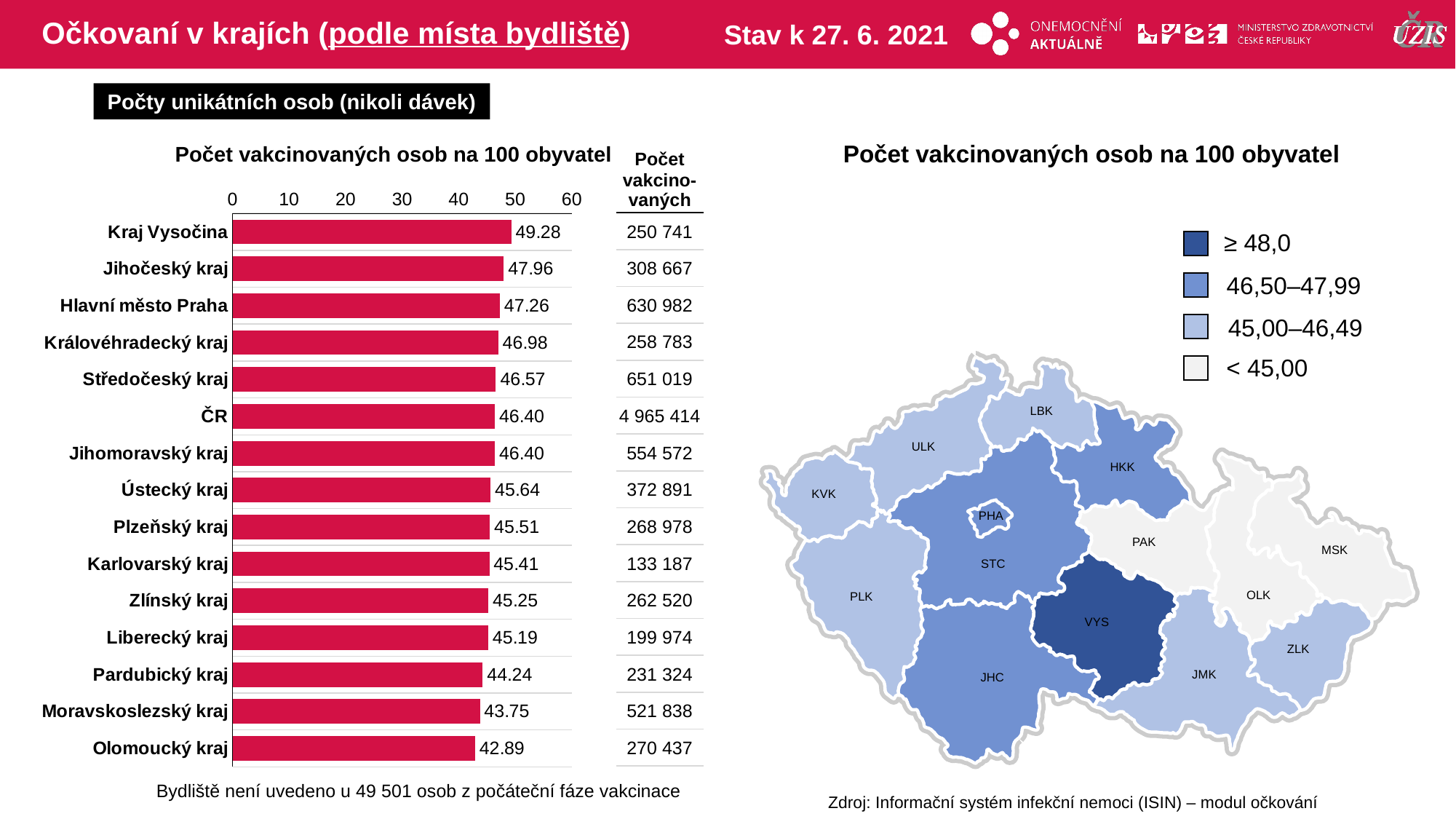
In the bar chart 'Počet vakcinovaných osob na 100 obyvatel', which region has the lowest value? Olomoucký kraj In the bar chart 'Počet vakcinovaných osob na 100 obyvatel', which region has the highest value? Kraj Vysočina In the bar chart 'Počet vakcinovaných osob na 100 obyvatel', what is the difference between Kraj Vysočina and Olomoucký kraj? 6.39 In the bar chart 'Počet vakcinovaných osob na 100 obyvatel', which is larger, Jihočeský kraj or Středočeský kraj? Jihočeský kraj In the bar chart 'Počet vakcinovaných osob na 100 obyvatel', is the value for Moravskoslezský kraj greater or less than 40? greater In the bar chart 'Počet vakcinovaných osob na 100 obyvatel', what is the value for Hlavní město Praha? 47.26 How many bars are shown in the bar chart 'Počet vakcinovaných osob na 100 obyvatel'? 15 In the table column 'Počet vakcinovaných' next to the bar chart, what is the value for Hlavní město Praha? 630 982 In the bar chart 'Počet vakcinovaných osob na 100 obyvatel', what is the value for Kraj Vysočina? 49.28 What kind of chart is used on the left side of the slide to show 'Počet vakcinovaných osob na 100 obyvatel'? bar chart In the map legend on the right, what range does the darkest blue colour represent? ≥ 48,0 In the bar chart 'Počet vakcinovaných osob na 100 obyvatel', what is the value for ČR? 46.40